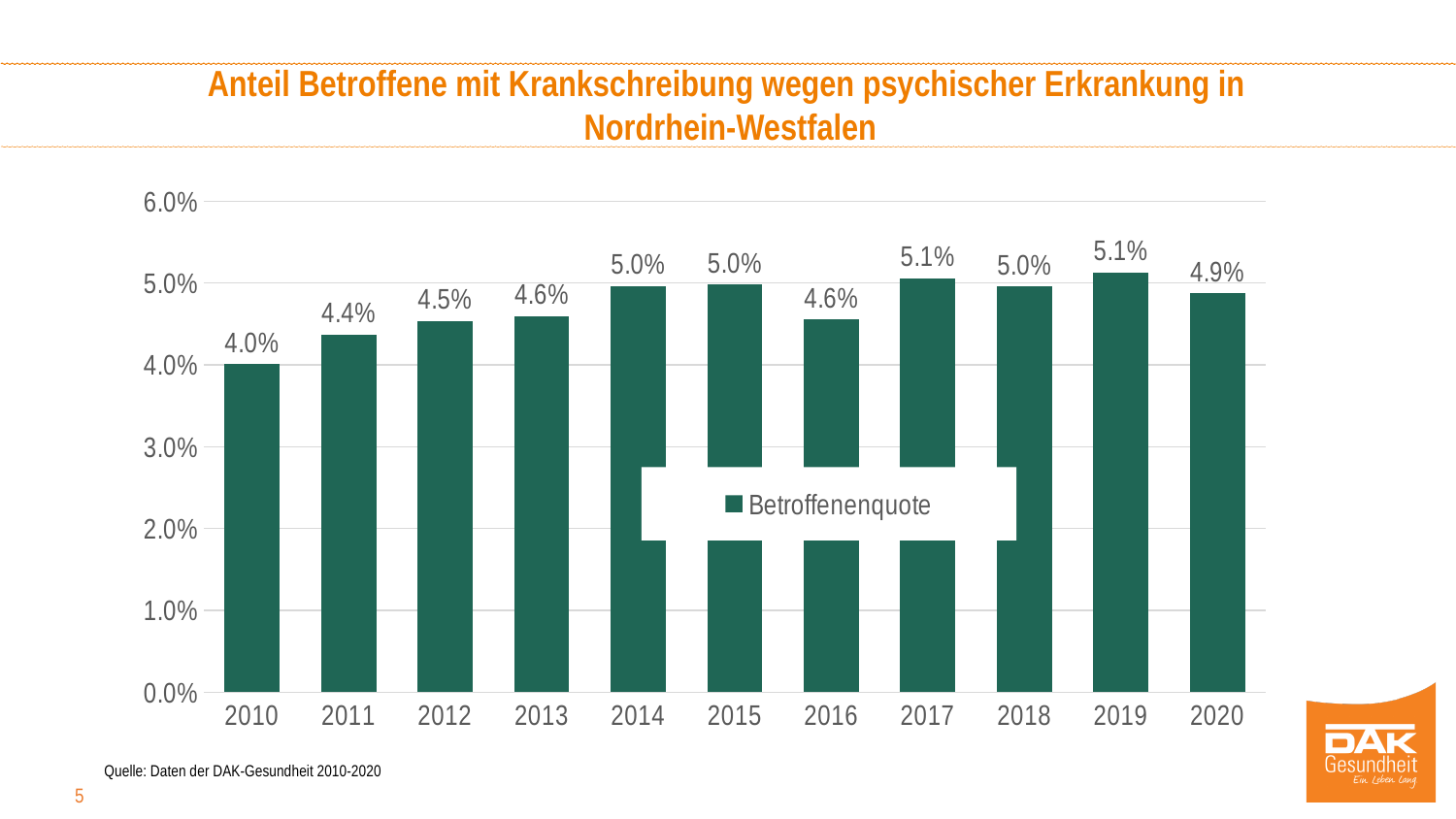
What kind of chart is shown on the slide? bar chart What is the Betroffenenquote for 2010? 4.0% Which year has the lowest Betroffenenquote? 2010 Which year has a higher Betroffenenquote, 2011 or 2017? 2017 What is the highest Betroffenenquote value shown in the chart? 5.1% What is the name of the series shown in the legend? Betroffenenquote What is the difference between the Betroffenenquote in 2019 and in 2010? 1.1% How many years are shown on the x axis? 11 How many series does the legend list? 1 What is the Betroffenenquote for 2020? 4.9% What is the Betroffenenquote for 2016? 4.6% Is the value for 2013 greater or less than 5.0%? less